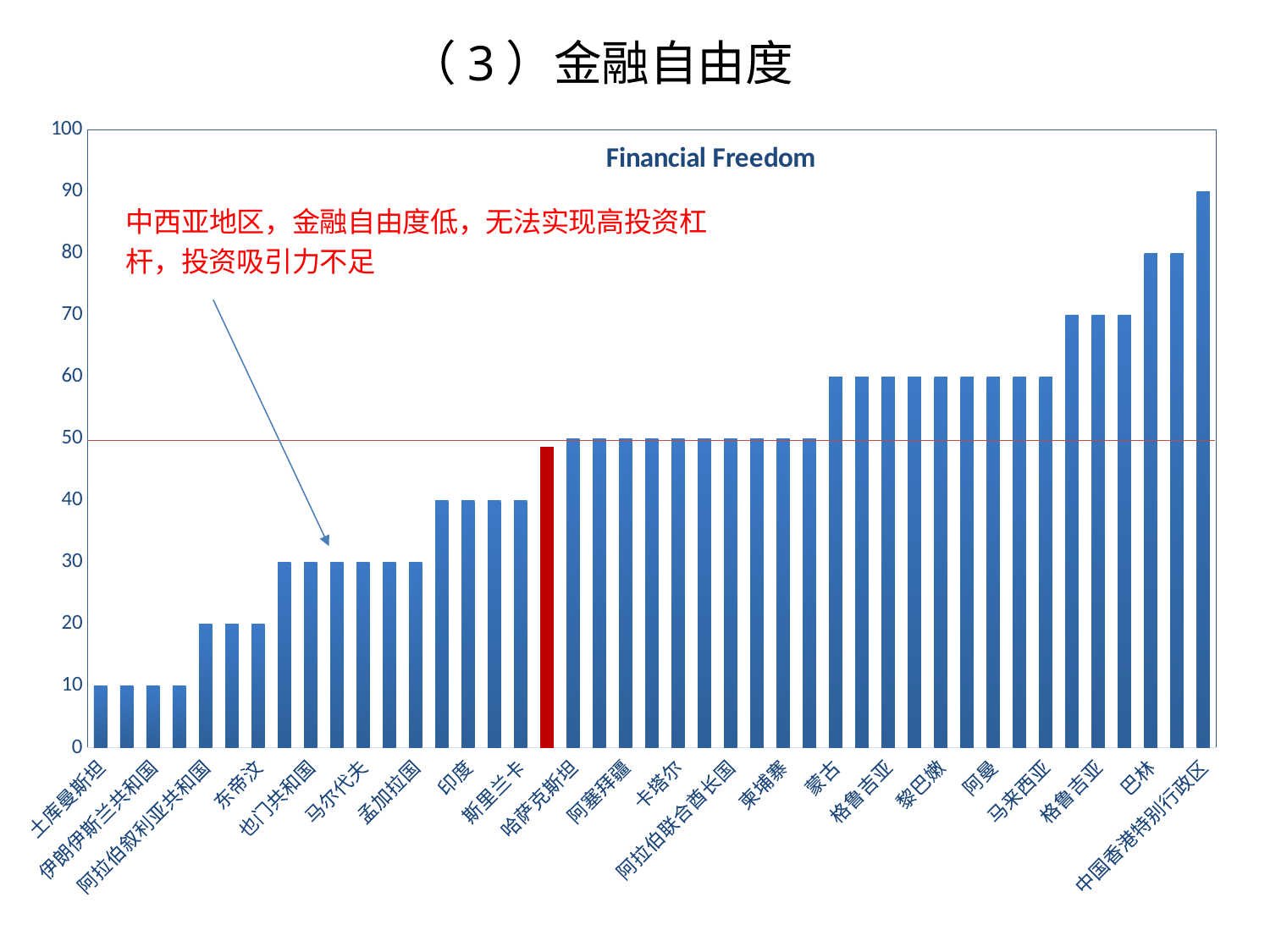
Which has a larger Financial Freedom value, 中国香港特别行政区 or 土库曼斯坦? 中国香港特别行政区 What is the difference between the Financial Freedom values of 中国香港特别行政区 and 土库曼斯坦? 80 What is the title printed inside the chart? Financial Freedom What is the Financial Freedom value for 巴林? 80 Is the value for 格鲁吉亚 greater or less than 50? greater Do the bar values rise or fall from left to right along the x axis? rise Is the value for 印度 greater or less than 50? less What is the Financial Freedom value for 中国香港特别行政区? 90 Is the value of the red highlighted bar greater or less than 50? less What kind of chart is shown on the slide? bar chart What is the Financial Freedom value for 土库曼斯坦? 10 Which category has the highest Financial Freedom value? 中国香港特别行政区